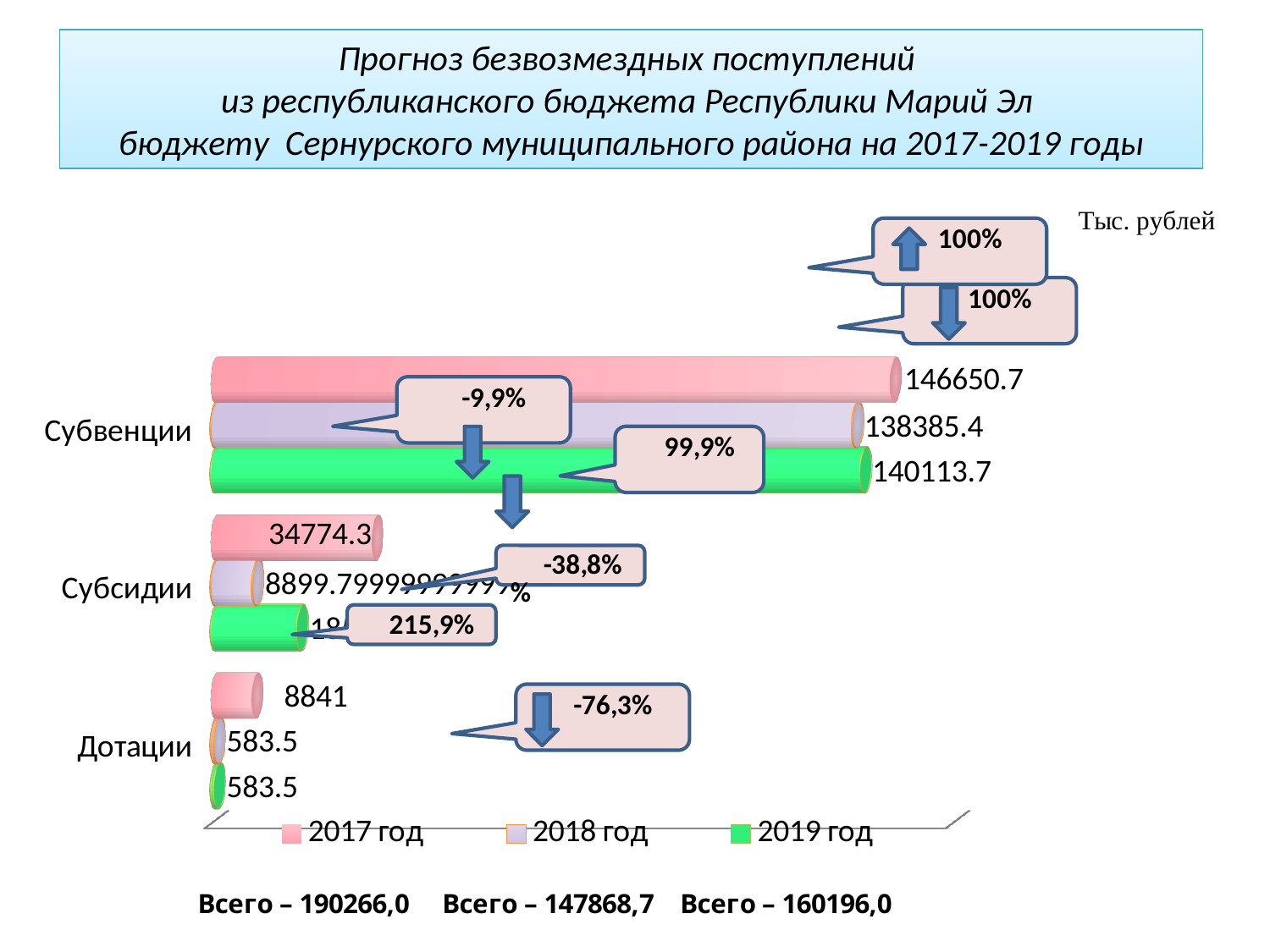
What is the value for Субсидии in 2017 год? 34774.3 How many series does the legend list? 3 What kind of chart is shown on the slide? bar chart What is the value for Субвенции in 2017 год? 146650.7 What is the value for Субвенции in 2018 год? 138385.4 What is the value for Субвенции in 2019 год? 140113.7 What is the difference between the 2017 год and 2018 год values for Субвенции? 8265.3 What is the value for Дотации in 2017 год? 8841 Which category has the lowest value in 2019 год? Дотации How many categories are shown on the chart? 3 What is the value for Дотации in 2018 год? 583.5 Which category has the highest value in 2017 год? Субвенции